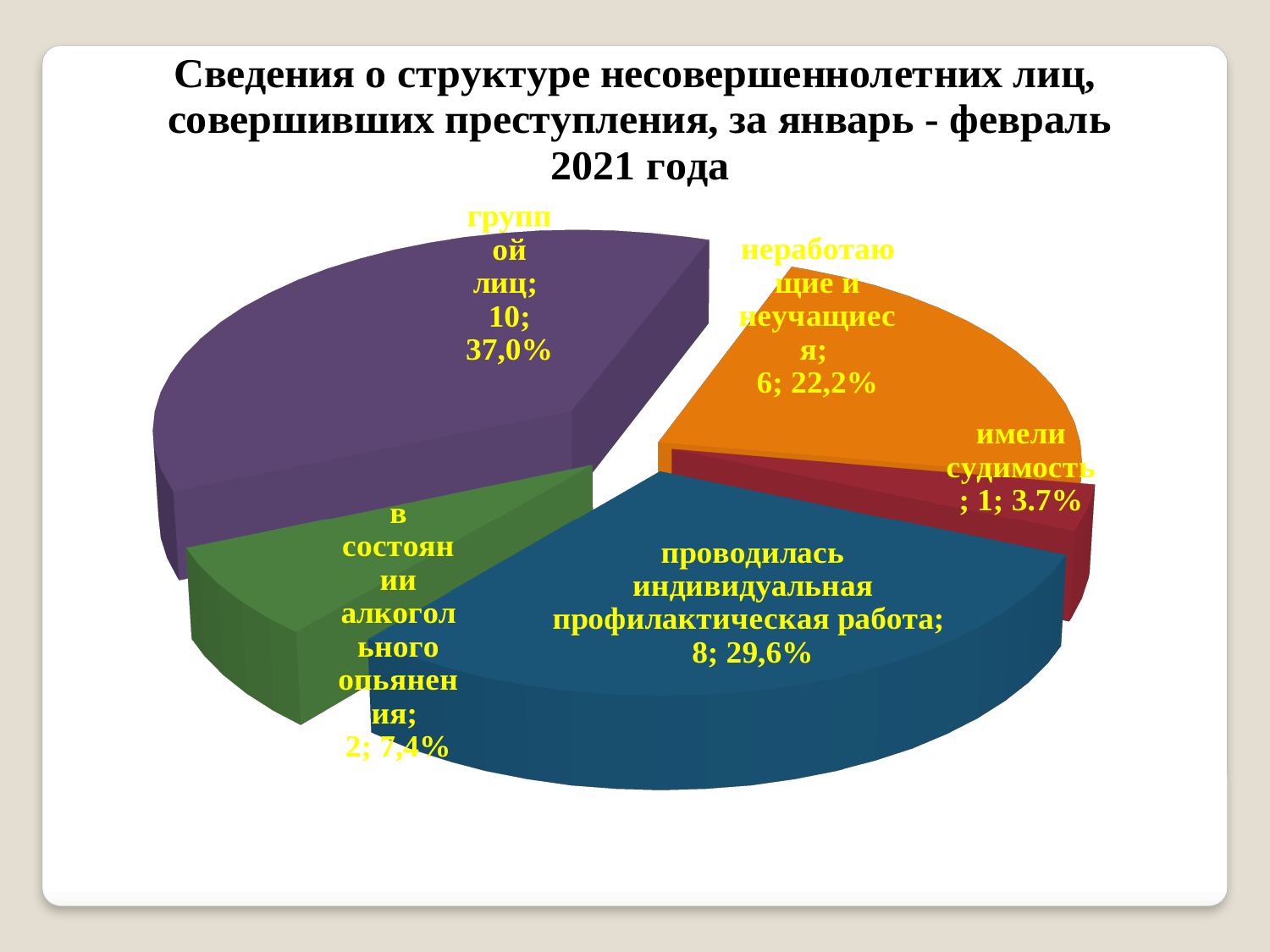
What is the difference between the values for "группой лиц" and "проводилась индивидуальная профилактическая работа"? 2 What is the value for "имели судимость"? 1 What share of the pie does "в состоянии алкогольного опьянения" represent? 7,4% What is the value for "группой лиц"? 10 Which is larger: the value for "неработающие и неучащиеся" or the value for "в состоянии алкогольного опьянения"? неработающие и неучащиеся Which category has the largest slice? группой лиц What kind of chart is shown on the slide? pie chart What share of the pie does "группой лиц" represent? 37,0% Which category has the smallest slice? имели судимость What is the value for "неработающие и неучащиеся"? 6 What share of the pie does "проводилась индивидуальная профилактическая работа" represent? 29,6% How many slices does the pie chart have? 5